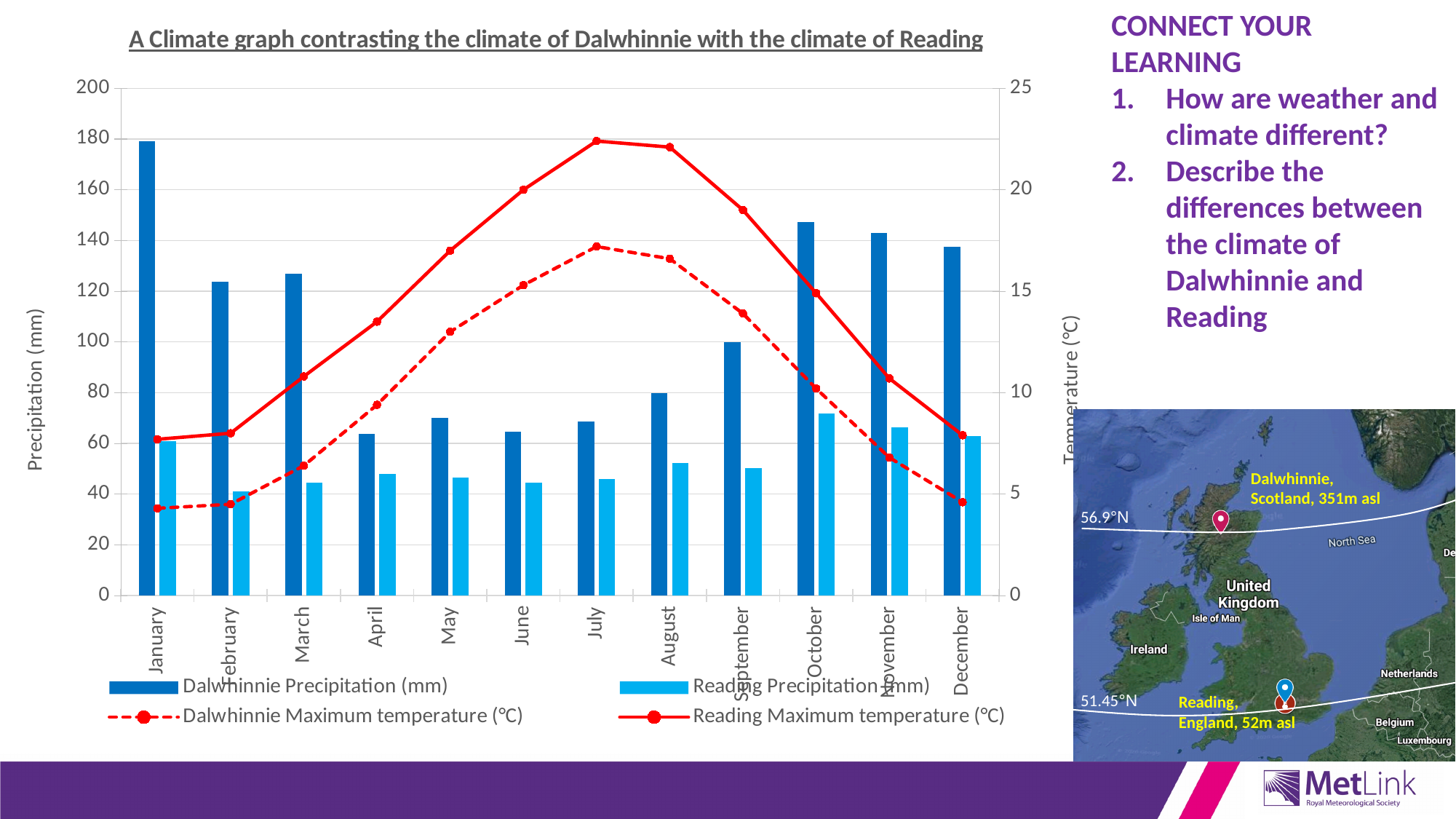
Which is higher in July, the Reading maximum temperature or the Dalwhinnie maximum temperature? Reading maximum temperature How many months are shown along the x axis? 12 In which month is Dalwhinnie precipitation highest? January How many series does the legend list? 4 What kind of chart is shown on the slide? A combined bar and line chart What is the title of the chart? A Climate graph contrasting the climate of Dalwhinnie with the climate of Reading Is the Reading precipitation for October greater or less than 80? less Is the Dalwhinnie precipitation for January greater or less than 160? greater Is the Dalwhinnie maximum temperature for January greater or less than 5? less Which is larger in January, Dalwhinnie precipitation or Reading precipitation? Dalwhinnie precipitation In which month is Reading precipitation highest? October Does the Reading maximum temperature rise or fall from January to July? rise